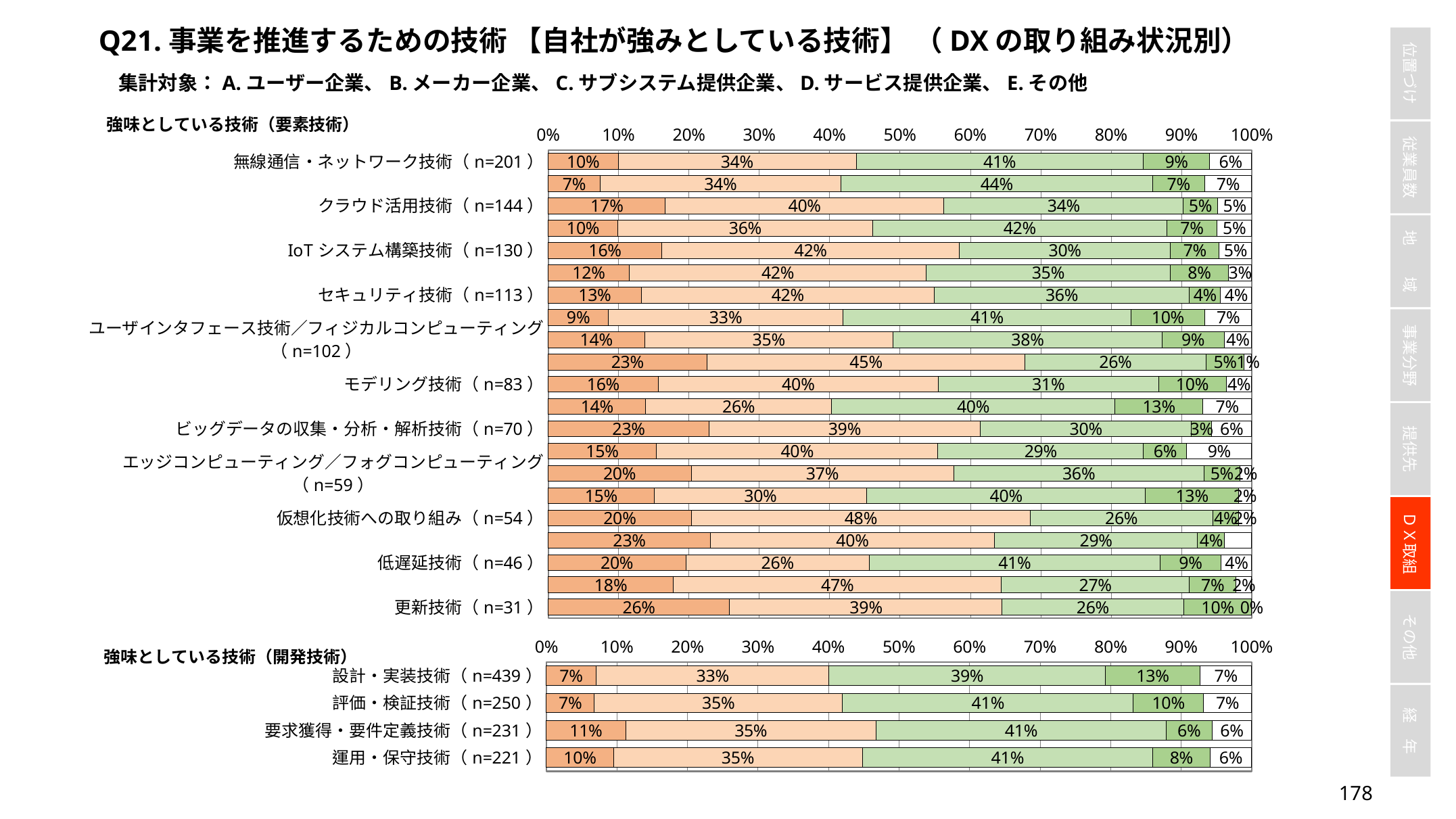
In the bottom chart (強味としている技術（開発技術）), what is the value of the light orange segment for 設計・実装技術 (n=439)? 33% What is the maximum value shown on the horizontal axis of the bottom chart (強味としている技術（開発技術）)? 100% In the bottom chart (強味としている技術（開発技術）), what is the value of the first (dark orange) segment for 要求獲得・要件定義技術 (n=231)? 11% In the bottom chart (強味としている技術（開発技術）), what is the value of the first (dark orange) segment for 設計・実装技術 (n=439)? 7% In the bottom chart (強味としている技術（開発技術）), which category has the lowest value in the dark green segment? 要求獲得・要件定義技術 (n=231) In the bottom chart (強味としている技術（開発技術）), what is the difference between the light green segment of 評価・検証技術 (41%) and that of 設計・実装技術 (39%)? 2% In the bottom chart (強味としている技術（開発技術）), what is the value of the dark green segment for 運用・保守技術 (n=221)? 8% In the bottom chart (強味としている技術（開発技術）), which category has the highest value in the dark green segment? 設計・実装技術 (n=439) In the bottom chart (強味としている技術（開発技術）), what is the value of the light green segment for 評価・検証技術 (n=250)? 41% In the bottom chart (強味としている技術（開発技術）), how many categories are plotted? 4 In the bottom chart (強味としている技術（開発技術）), which is larger: the dark orange segment for 要求獲得・要件定義技術 or for 運用・保守技術? 要求獲得・要件定義技術 What kind of chart is the bottom chart (強味としている技術（開発技術）)? Stacked bar chart